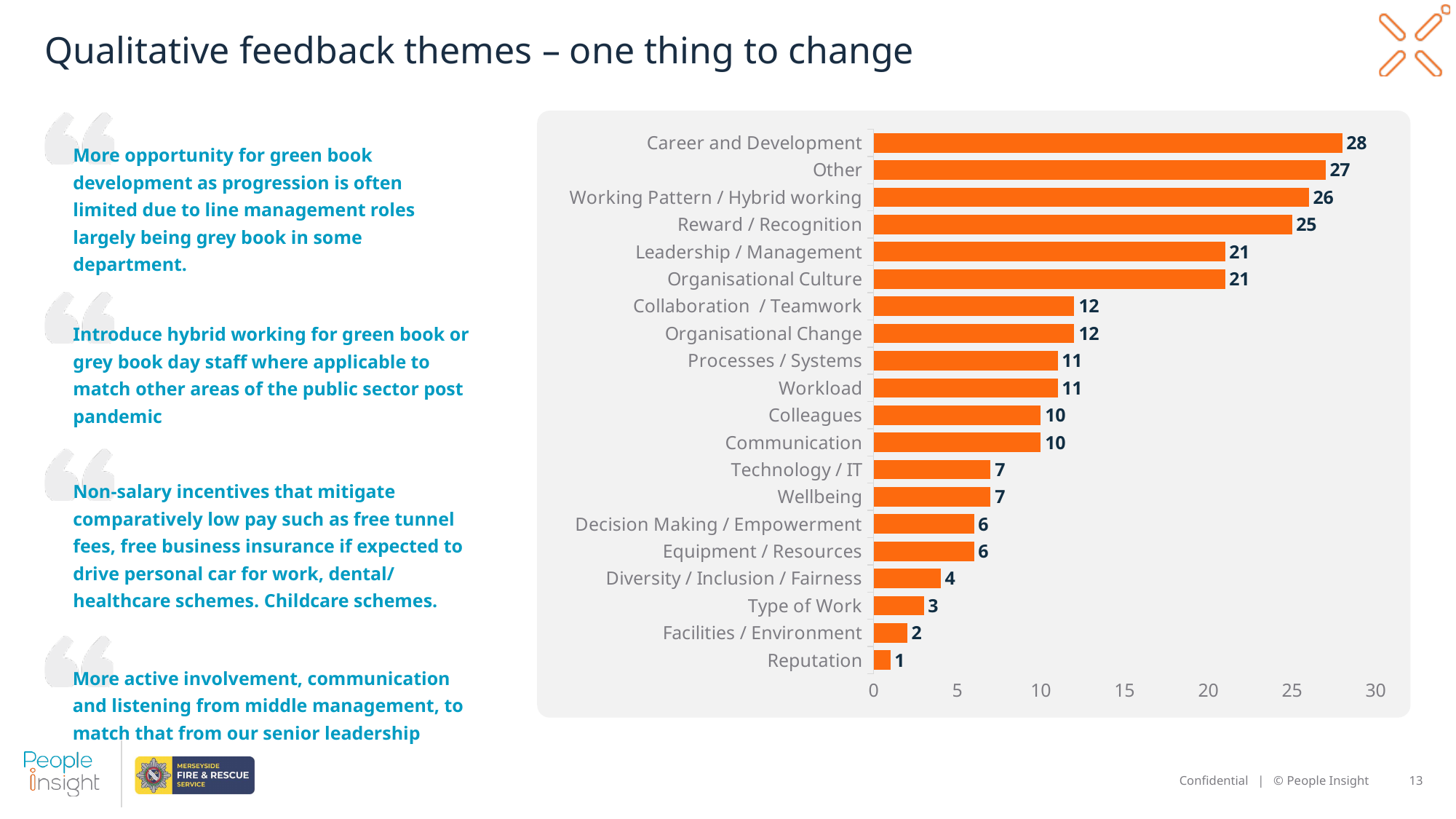
Which category has the lowest value? Reputation What is the difference between the values for Other and Organisational Culture? 6 What is the difference between the values for Leadership / Management and Workload? 10 What kind of chart is shown on the slide? Bar chart What is the value for Wellbeing? 7 Which is larger, the value for Collaboration / Teamwork or the value for Technology / IT? Collaboration / Teamwork What is the value for Reward / Recognition? 25 How many categories are shown in the chart? 20 What is the value for Career and Development? 28 Is the value for Working Pattern / Hybrid working greater or less than 20? greater What colour are the bars in the chart? Orange Which category has the highest value? Career and Development